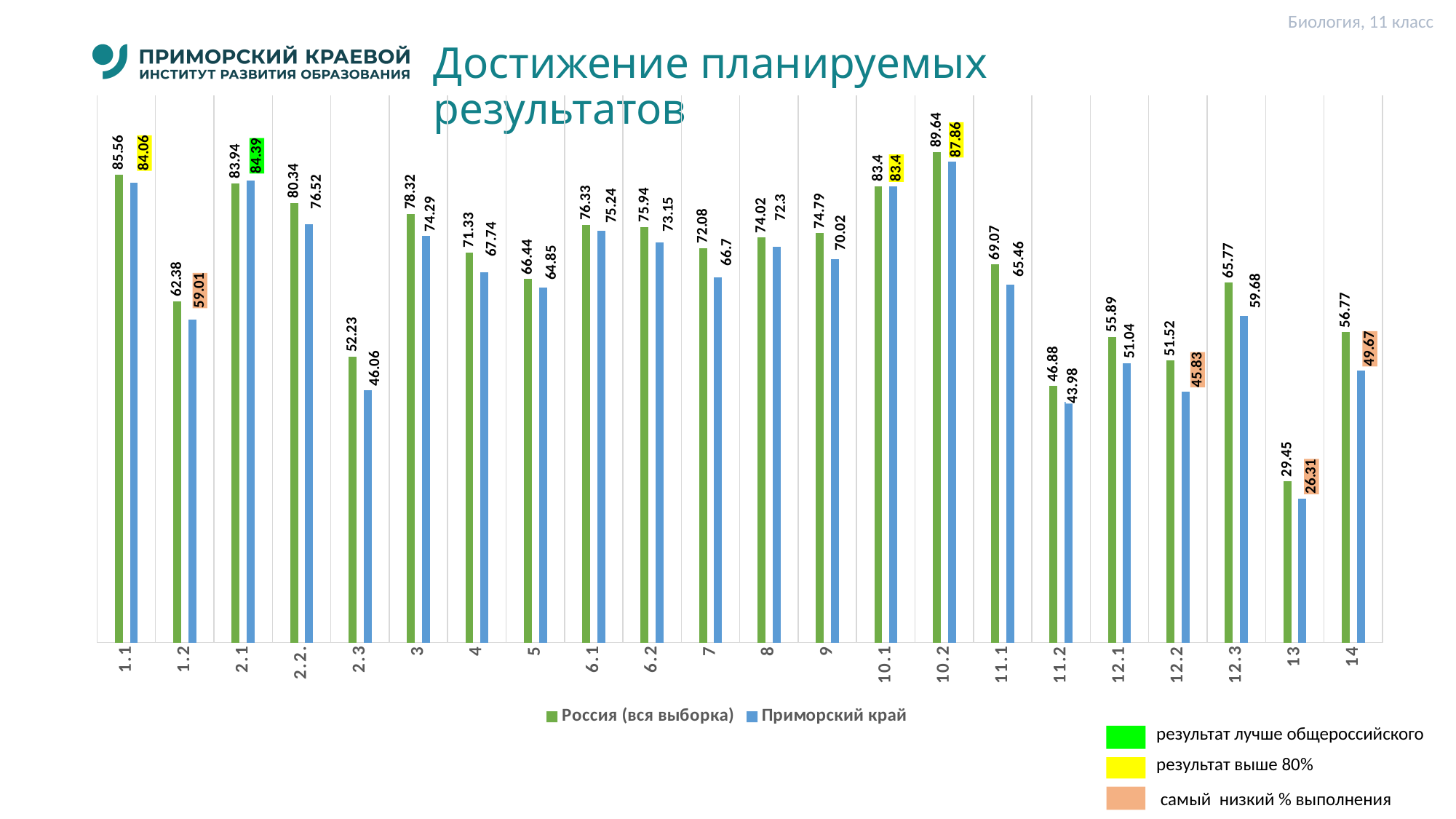
What is the value for Приморский край for category 13? 26.31 How many categories are shown on the x axis? 22 Which colour represents the series Приморский край in the chart? blue What is the value for Россия (вся выборка) for category 2.3? 52.23 What kind of chart is shown on the slide? bar chart What is the difference between the Россия (вся выборка) and Приморский край values for category 14? 7.1 Which category has the highest value for Россия (вся выборка)? 10.2 For category 2.1, which series has the larger value: Россия (вся выборка) or Приморский край? Приморский край Which category has the lowest value for Приморский край? 13 What is the value for Россия (вся выборка) for category 11.2? 46.88 How many series does the legend list? 2 What is the value for Приморский край for category 10.2? 87.86